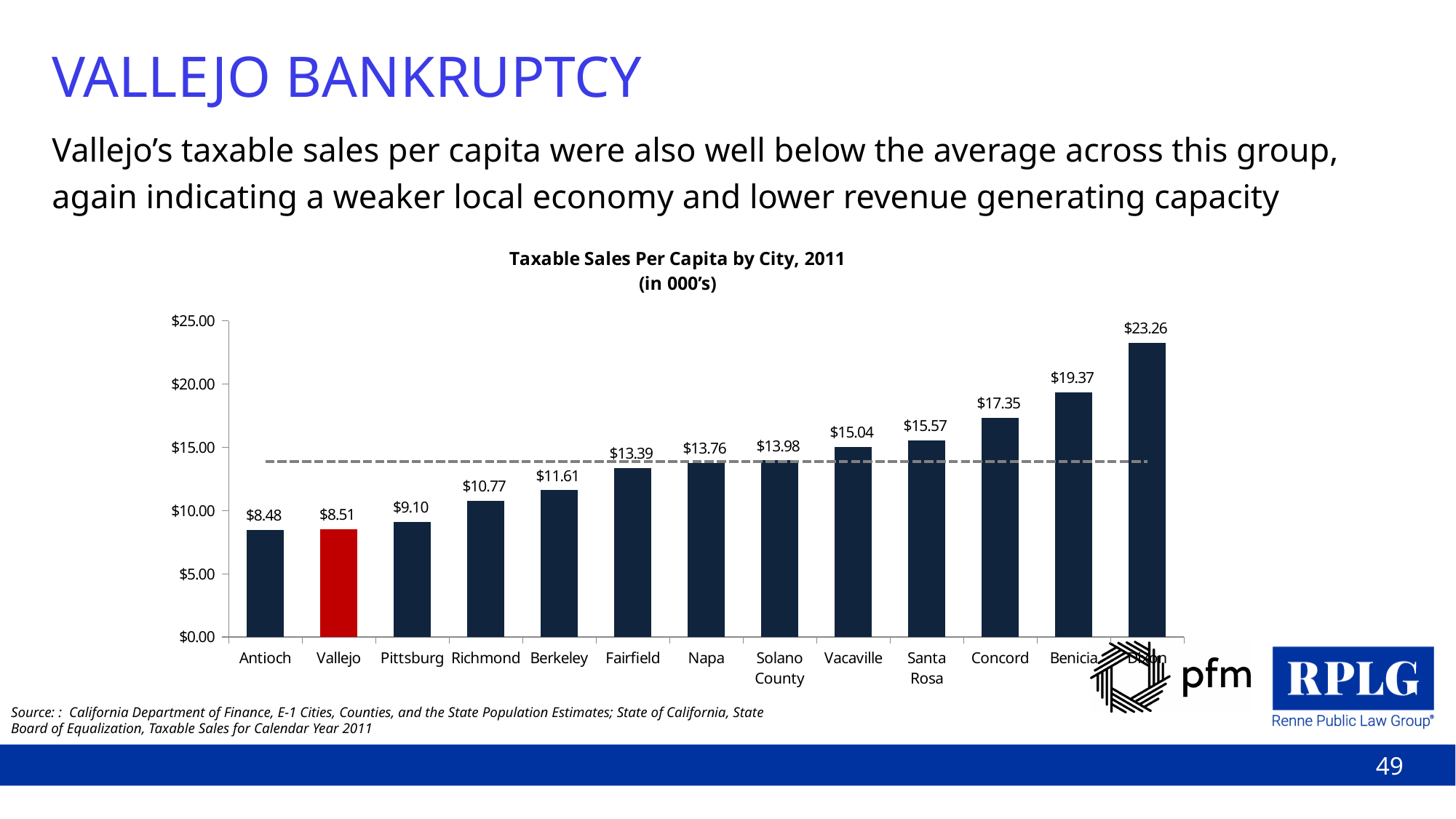
What is the difference between the values for Benicia and Concord? $2.02 Which has a higher value, Napa or Fairfield? Napa What is the taxable sales per capita value shown for Vallejo? $8.51 What kind of chart is shown on the slide? Bar chart What is the difference between the values for Vallejo and Antioch? $0.03 Which bar is coloured red in the chart? Vallejo Which city has the lowest taxable sales per capita in the chart? Antioch What is the value shown for Benicia? $19.37 How many cities or counties are shown in the chart? 13 What is the highest value shown in the chart? $23.26 What is the value shown for Richmond? $10.77 What is the value shown for Solano County? $13.98